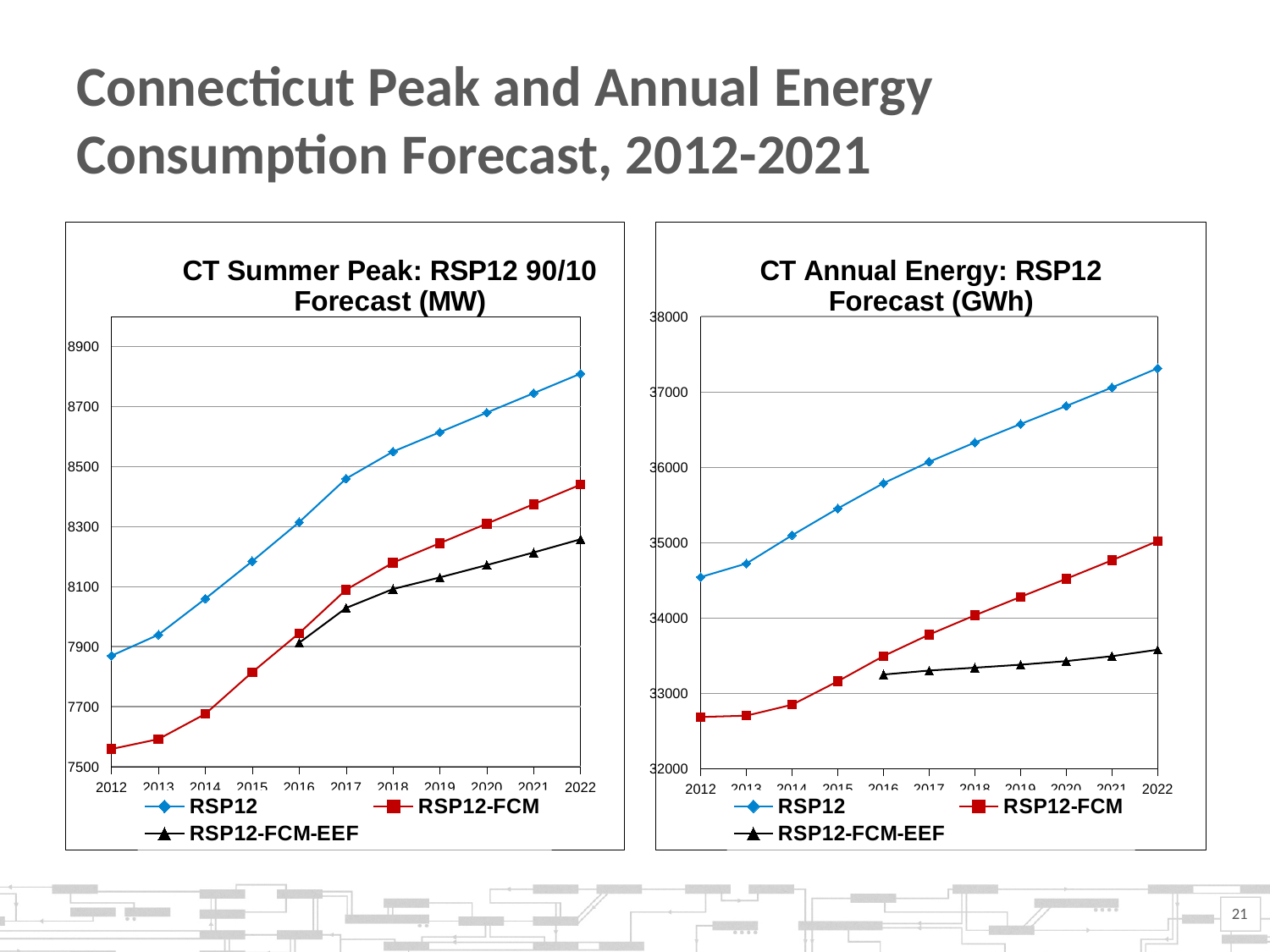
In the CT Summer Peak: RSP12 90/10 Forecast (MW) chart, does the RSP12 series rise or fall from 2012 to 2022? rise In the CT Summer Peak: RSP12 90/10 Forecast (MW) chart, which series has the higher value in 2022, RSP12 or RSP12-FCM? RSP12 What kind of chart is the CT Summer Peak: RSP12 90/10 Forecast (MW) chart? line chart How many series does the legend of the CT Annual Energy: RSP12 Forecast (GWh) chart list? 3 In the CT Annual Energy: RSP12 Forecast (GWh) chart, which series has the highest value in 2022? RSP12 In the CT Annual Energy: RSP12 Forecast (GWh) chart, is the value for RSP12-FCM-EEF in 2022 greater or less than 34000? less In the CT Summer Peak: RSP12 90/10 Forecast (MW) chart, is the value for RSP12 in 2022 greater or less than 8700? greater In the CT Annual Energy: RSP12 Forecast (GWh) chart, which series has the lowest value in 2022? RSP12-FCM-EEF In the CT Annual Energy: RSP12 Forecast (GWh) chart, does the RSP12-FCM series rise or fall from 2012 to 2022? rise In the CT Annual Energy: RSP12 Forecast (GWh) chart, is the value for RSP12 in 2022 greater or less than 37000? greater How many years are shown on the x axis of the CT Summer Peak: RSP12 90/10 Forecast (MW) chart? 11